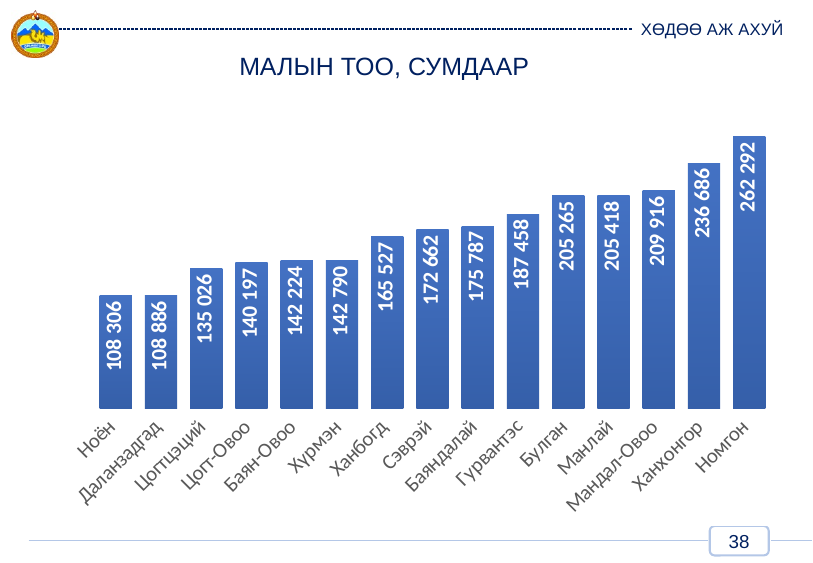
Which category has the lowest value? Ноён Which category has the highest value? Номгон How many categories are shown in the chart? 15 Which is larger, the value for Сэврэй or the value for Баяндалай? Баяндалай What is the title of the chart? МАЛЫН ТОО, СУМДААР What kind of chart is shown on the slide? Bar chart What is the value for Гурвантэс? 187 458 What is the value for Ханбогд? 165 527 What is the difference between the values for Цогтцэций and Ноён? 26 720 What is the value for Даланзадгад? 108 886 What is the value for Номгон? 262 292 What is the difference between the values for Номгон and Ханхонгор? 25 606